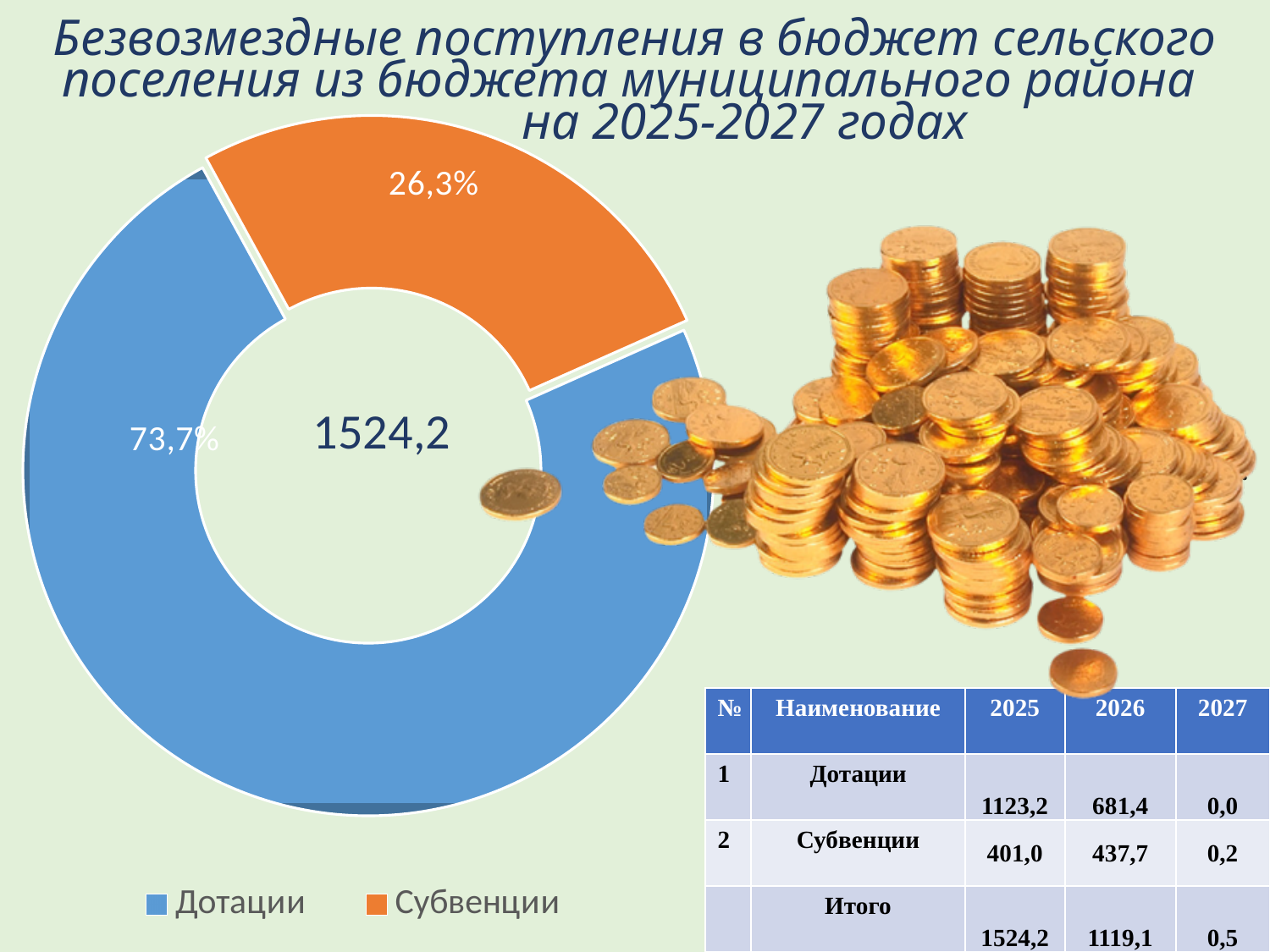
What colour is the Дотации slice in the doughnut chart? blue Which category has the largest slice in the doughnut chart? Дотации What share of the doughnut chart does Субвенции take? 26,3% What share of the doughnut chart does Дотации take? 73,7% Which category has the smallest slice in the doughnut chart? Субвенции What colour is the Субвенции slice in the doughnut chart? orange What is the difference in percentage points between the Дотации and Субвенции slices? 47,4 What value is printed in the centre of the doughnut chart? 1524,2 How many entries does the chart legend list? 2 How many slices does the doughnut chart have? 2 Which slice is larger, Дотации or Субвенции? Дотации What kind of chart is shown on the slide? doughnut (pie) chart